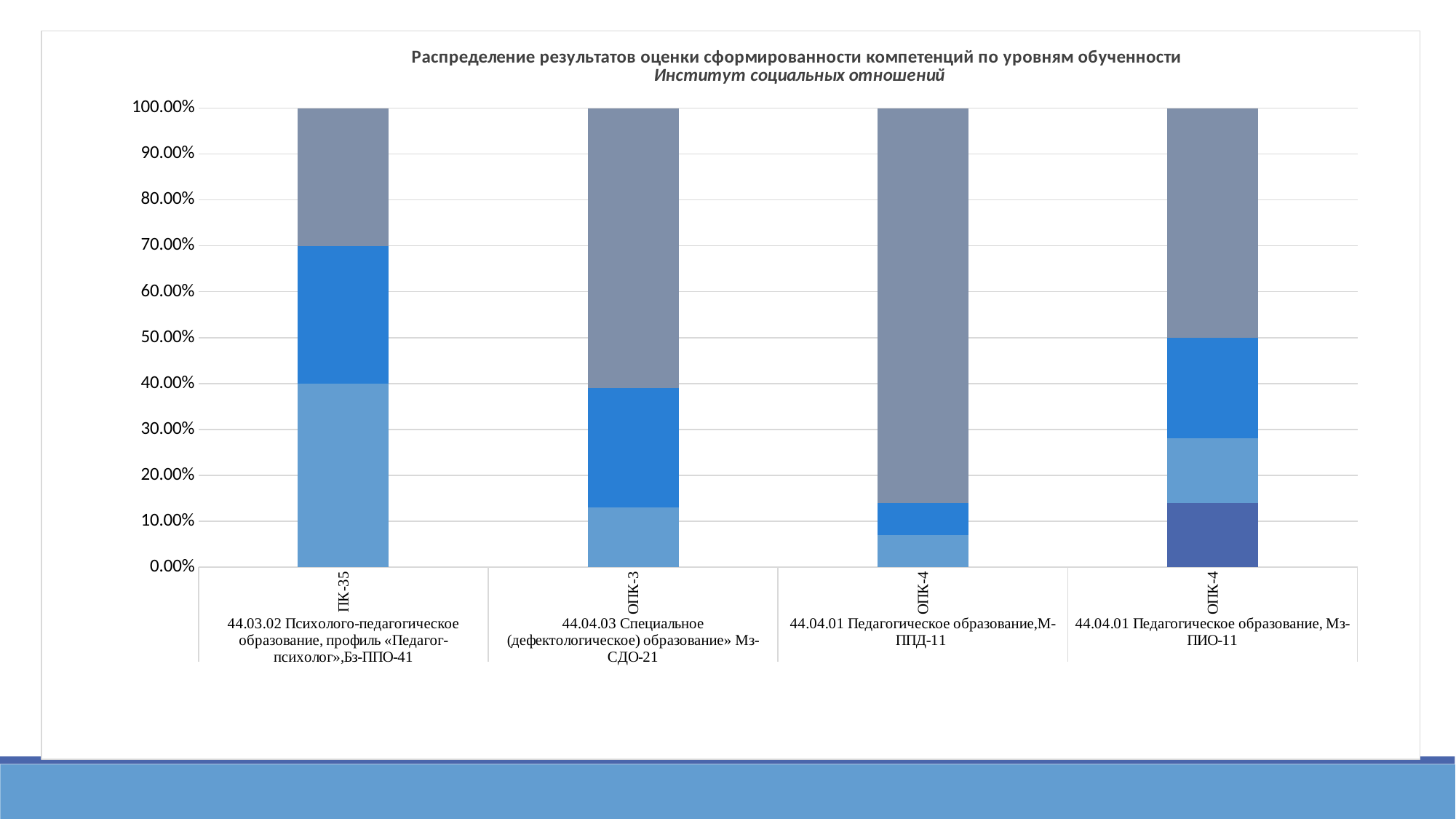
At what value on the axis does the medium blue segment of the ОПК-4 bar for 44.04.01 Мз-ПИО-11 end? 50.00% At what value on the axis does the medium blue segment of the ПК-35 bar (44.03.02, Бз-ППО-41) end? 70.00% At what value on the axis does the light blue segment of the ПК-35 bar (44.03.02, Бз-ППО-41) end? 40.00% What is the total height of each stacked bar in the chart? 100.00% How many bars (categories) are plotted in the chart? 4 Which bar has the largest gray segment? ОПК-4 (44.04.01 Педагогическое образование, М-ППД-11) Is the light blue segment of the ОПК-3 bar (44.04.03, Мз-СДО-21) greater or less than 20%? less Which institute is named in the chart's subtitle? Институт социальных отношений Which bar has a larger light blue segment: ПК-35 (Бз-ППО-41) or ОПК-3 (Мз-СДО-21)? ПК-35 (Бз-ППО-41) What kind of chart is shown on the slide? Stacked bar chart Is the gray segment of the ОПК-4 bar for 44.04.01 М-ППД-11 greater or less than 80%? greater What is the title of the chart? Распределение результатов оценки сформированности компетенций по уровням обученности